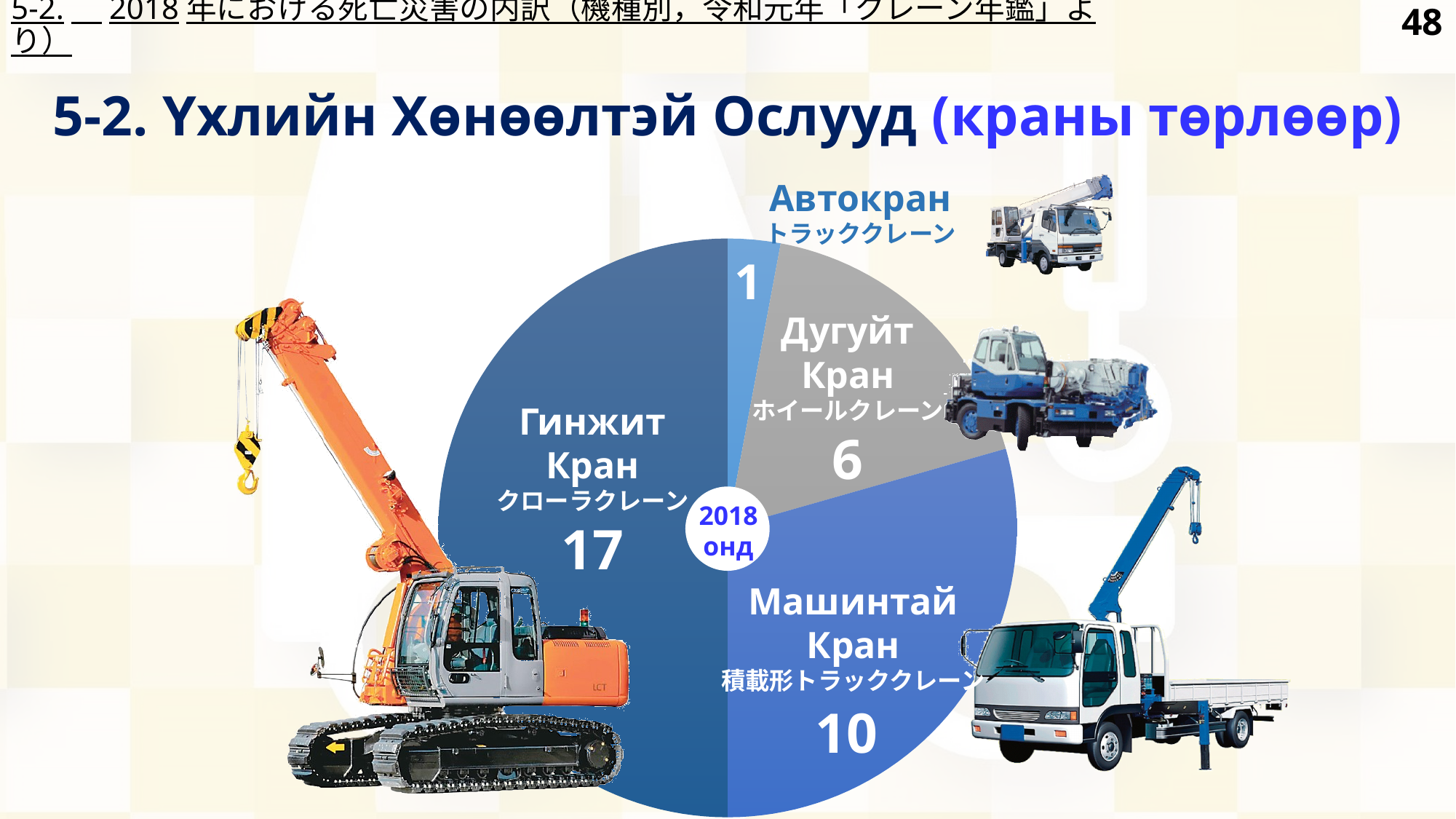
How many slices does the pie chart have? 4 What is the value for Дугуйт Кран? 6 Which crane type has the smallest slice of the pie? Автокран What year is written in the centre of the pie chart? 2018 онд What is the value for Автокран? 1 What is the value for Машинтай Кран? 10 What kind of chart is shown on the slide? pie chart What is the total of all the values shown in the pie chart? 34 Which crane type has the largest slice of the pie? Гинжит Кран What is the value for Гинжит Кран? 17 Which is larger, the value for Дугуйт Кран or the value for Машинтай Кран? Машинтай Кран What is the difference between the values for Гинжит Кран and Машинтай Кран? 7